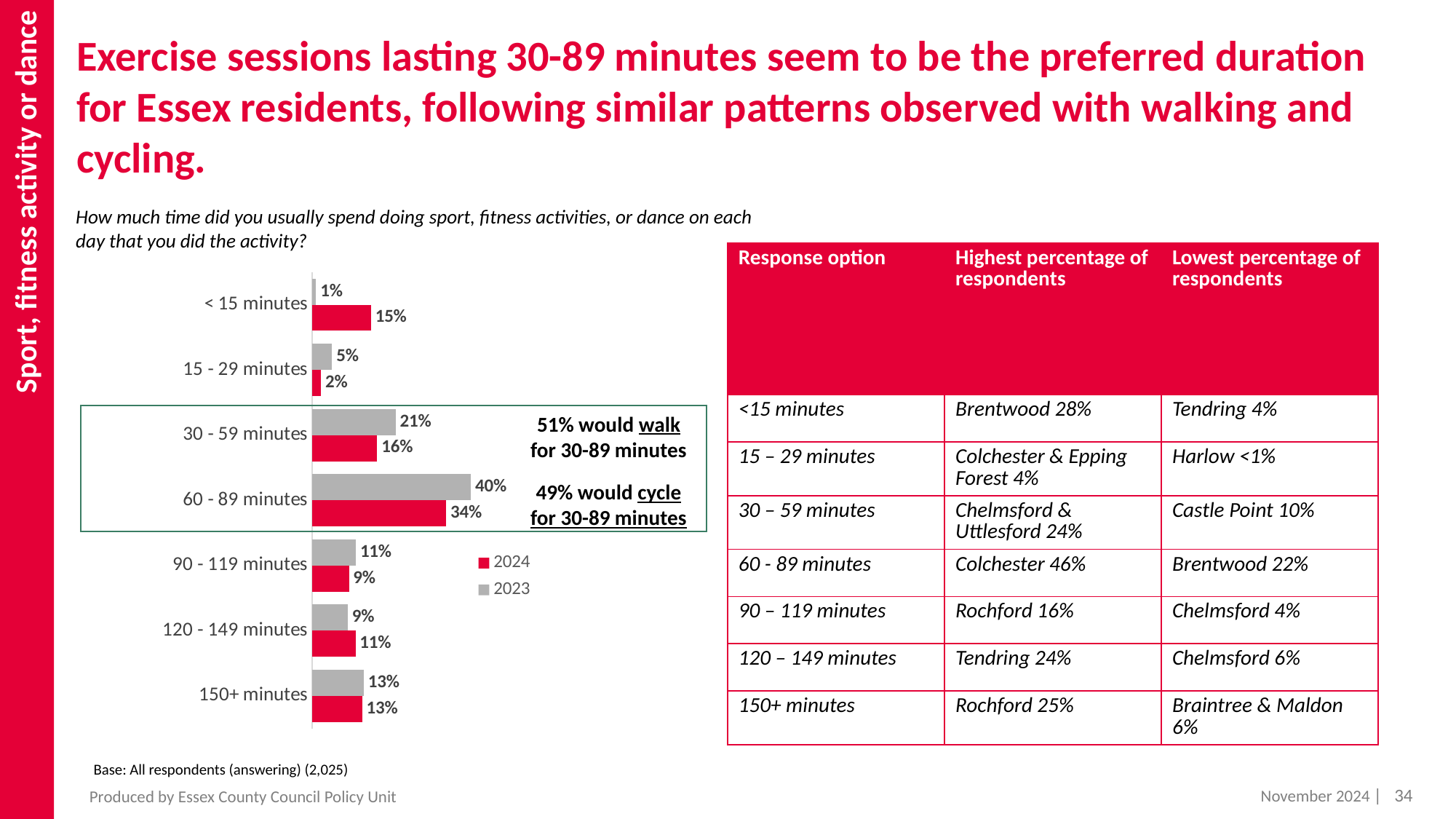
What is the difference between the 2023 and 2024 values for the 60 - 89 minutes category? 6 percentage points What percentage of respondents in 2024 spent less than 15 minutes on the activity? 15% For the 120 - 149 minutes category, which year has the larger value, 2023 or 2024? 2024 How many series does the chart legend list? 2 What is the difference between the 2024 and 2023 values for the < 15 minutes category? 14 percentage points Which duration category has the highest value for 2023? 60 - 89 minutes What type of chart is used to show the time spent on sport, fitness activity or dance? Bar chart Which duration category has the lowest value for 2024? 15 - 29 minutes How many duration categories are shown in the chart? 7 What was the 2023 value for the 30 - 59 minutes category? 21% What percentage of respondents in 2024 spent 60 - 89 minutes on sport, fitness activity or dance? 34% Which colour represents the 2024 series in the chart? Red